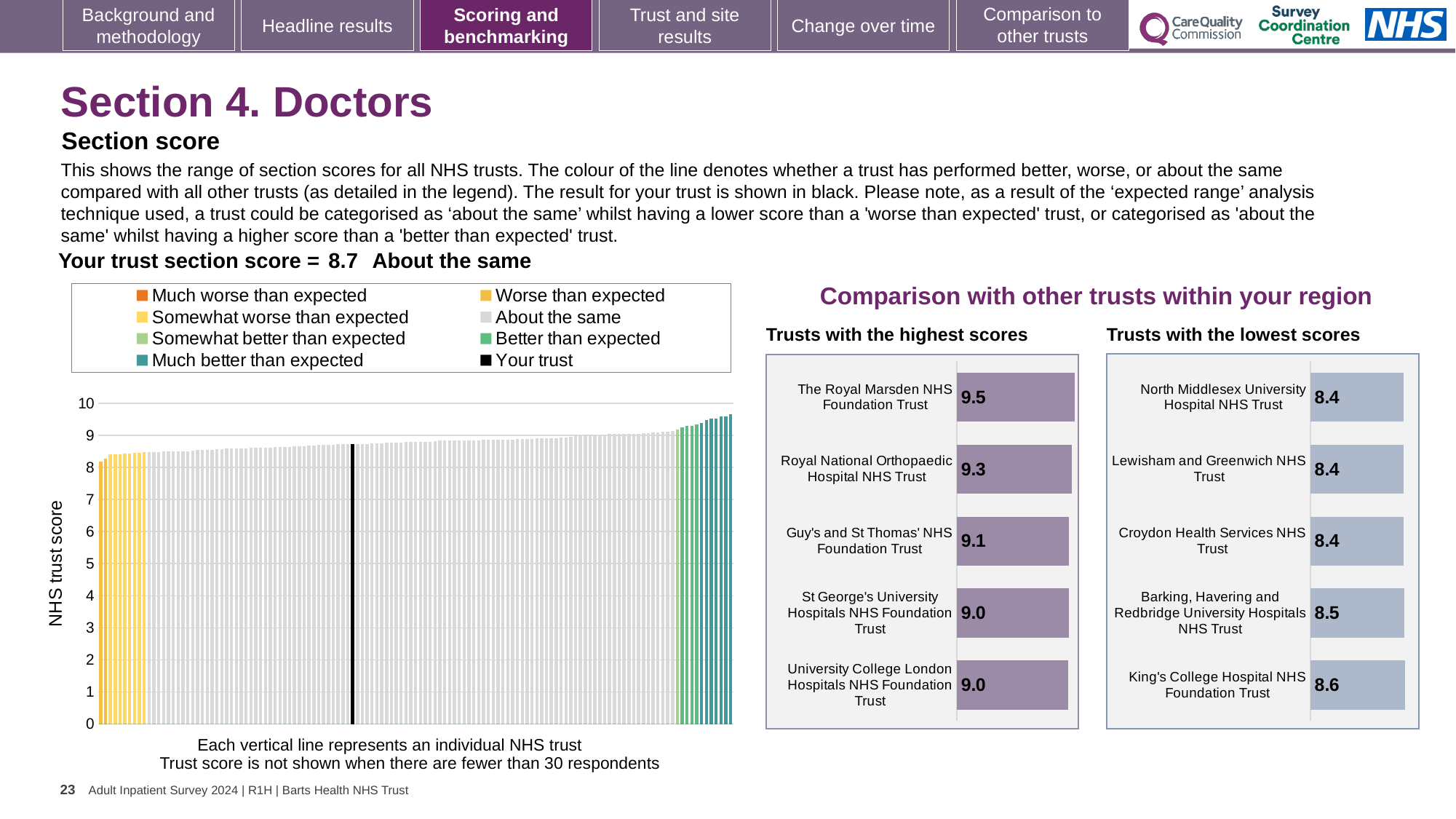
In the 'Trusts with the highest scores' chart, which trust has the highest score? The Royal Marsden NHS Foundation Trust In the 'Trusts with the lowest scores' chart, what is the score for Croydon Health Services NHS Trust? 8.4 In the 'Trusts with the lowest scores' chart, which trust has the highest score? King's College Hospital NHS Foundation Trust In the large chart on the left showing the range of section scores, how many entries does the legend list? 8 In the 'Trusts with the highest scores' chart, how many trusts are listed? 5 In the 'Trusts with the lowest scores' chart, what is the score for King's College Hospital NHS Foundation Trust? 8.6 In the 'Trusts with the highest scores' chart, what is the score for Guy's and St Thomas' NHS Foundation Trust? 9.1 In the large chart on the left showing the range of section scores, do the values rise or fall from left to right along the x axis? rise In the 'Trusts with the highest scores' chart, what is the difference between the scores of The Royal Marsden NHS Foundation Trust and Royal National Orthopaedic Hospital NHS Trust? 0.2 In the 'Trusts with the highest scores' chart, what is the score for The Royal Marsden NHS Foundation Trust? 9.5 In the 'Trusts with the lowest scores' chart, which has the larger score: Barking, Havering and Redbridge University Hospitals NHS Trust or King's College Hospital NHS Foundation Trust? King's College Hospital NHS Foundation Trust In the 'Trusts with the lowest scores' chart, what is the difference between the scores of King's College Hospital NHS Foundation Trust and North Middlesex University Hospital NHS Trust? 0.2